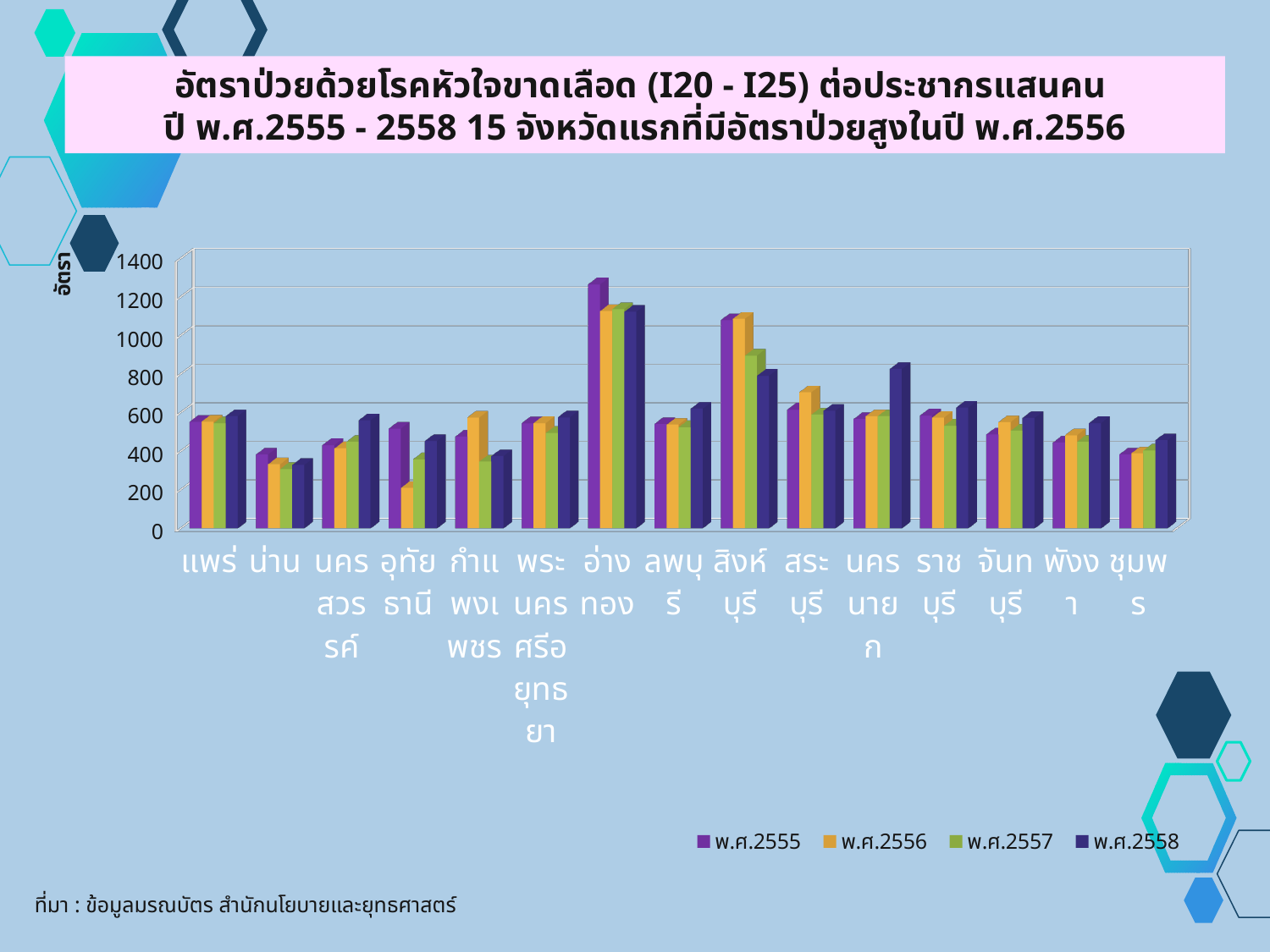
Is the value for น่าน in พ.ศ.2556 greater or less than 400? less How many provinces (categories) are shown on the x axis of the chart? 15 Which is larger for พ.ศ.2555: the value for อ่างทอง or the value for สิงห์บุรี? อ่างทอง What kind of chart is shown on the slide? bar chart Is the value for อ่างทอง in พ.ศ.2555 greater or less than 1200? greater Which series is shown in orange in the legend? พ.ศ.2556 Is the value for นครนายก in พ.ศ.2558 greater or less than 800? greater Which province has the lowest value for พ.ศ.2556? อุทัยธานี How many series does the legend list? 4 Which is larger for พ.ศ.2555: the value for แพร่ or the value for น่าน? แพร่ Which province has the highest value for พ.ศ.2555? อ่างทอง